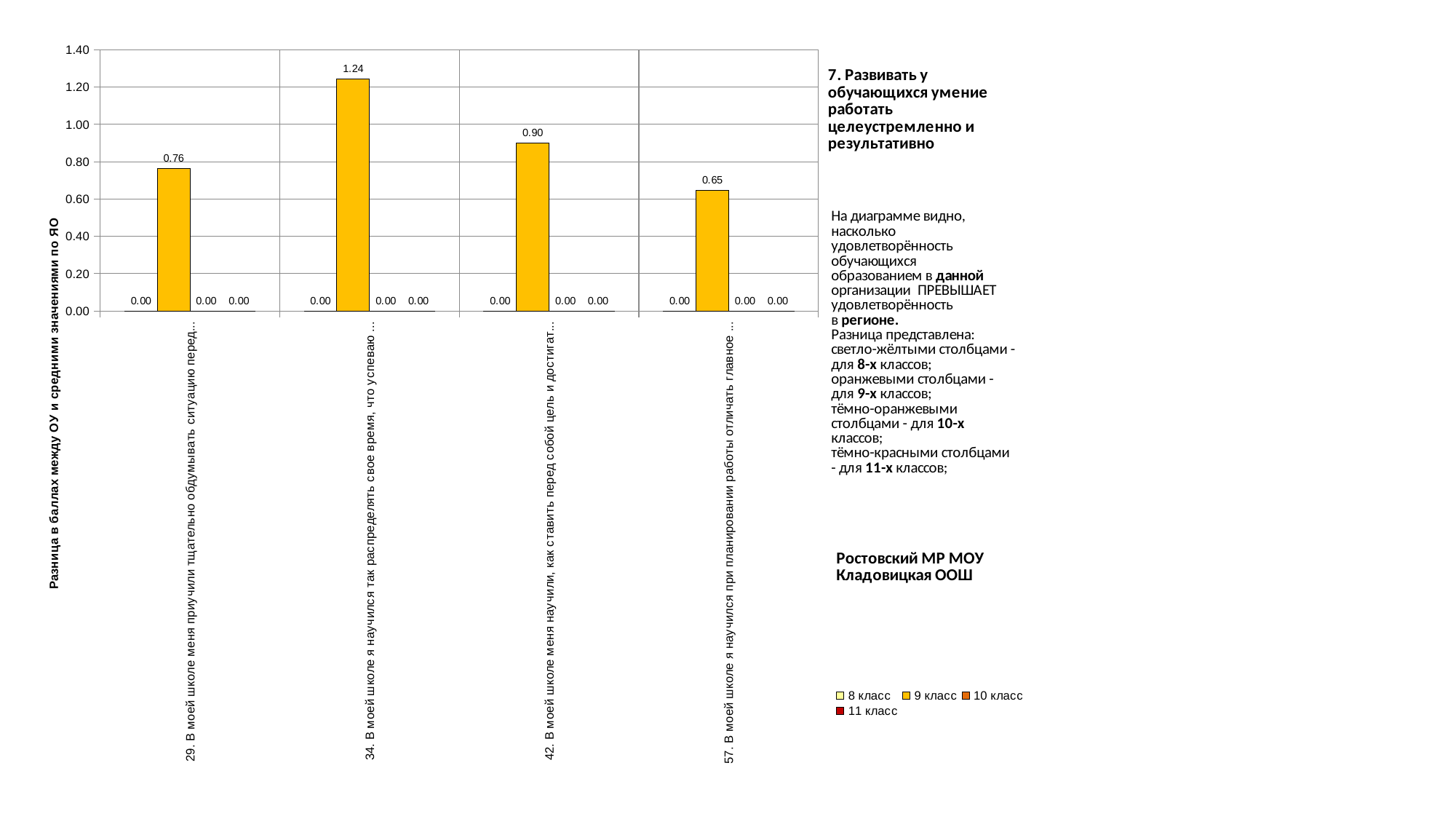
What is the value for 9 класс for question 34? 1.24 Which series is shown in the legend with a dark red colour? 11 класс What is the value for 8 класс for question 42? 0.00 What is the value for 9 класс for question 29? 0.76 For which question is the 9 класс value highest? 34 What is the difference between the 9 класс values for question 34 and question 42? 0.34 How many series does the legend list? 4 What is the value for 9 класс for question 57? 0.65 What type of chart is shown on the slide? bar chart For which question is the 9 класс value lowest? 57 Which is larger: the 9 класс value for question 29 or for question 42? question 42 How many categories (questions) are shown on the x axis? 4